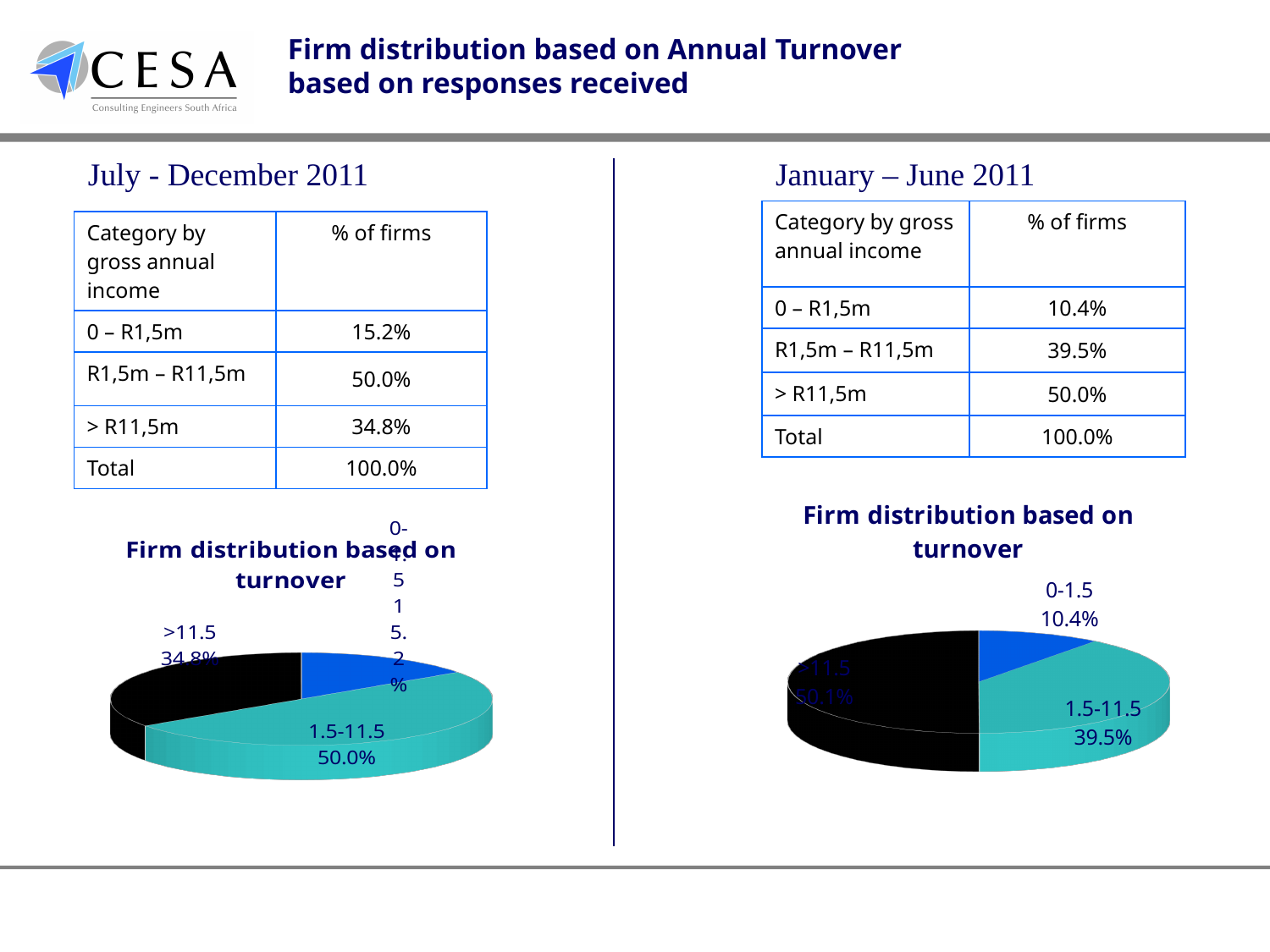
How many slices does the left pie chart (July - December 2011) have? 3 In the right pie chart (January – June 2011), which is larger: the 1.5-11.5 slice or the 0-1.5 slice? 1.5-11.5 In the left pie chart (July - December 2011), what is the difference between the 1.5-11.5 slice and the >11.5 slice? 15.2 percentage points In the right pie chart (January – June 2011), which category has the smallest slice? 0-1.5 In the left pie chart (July - December 2011), what is the value for the >11.5 slice? 34.8% In the left pie chart (July - December 2011), which category has the largest slice? 1.5-11.5 What is the title of the right pie chart (January – June 2011)? Firm distribution based on turnover In the right pie chart (January – June 2011), what is the value for the 0-1.5 slice? 10.4% In the right pie chart (January – June 2011), what is the value for the 1.5-11.5 slice? 39.5% In the right pie chart (January – June 2011), which category has the largest slice? >11.5 In the left pie chart (July - December 2011), what is the value for the 1.5-11.5 slice? 50.0% What kind of chart is the left chart on the slide (under July - December 2011)? Pie chart